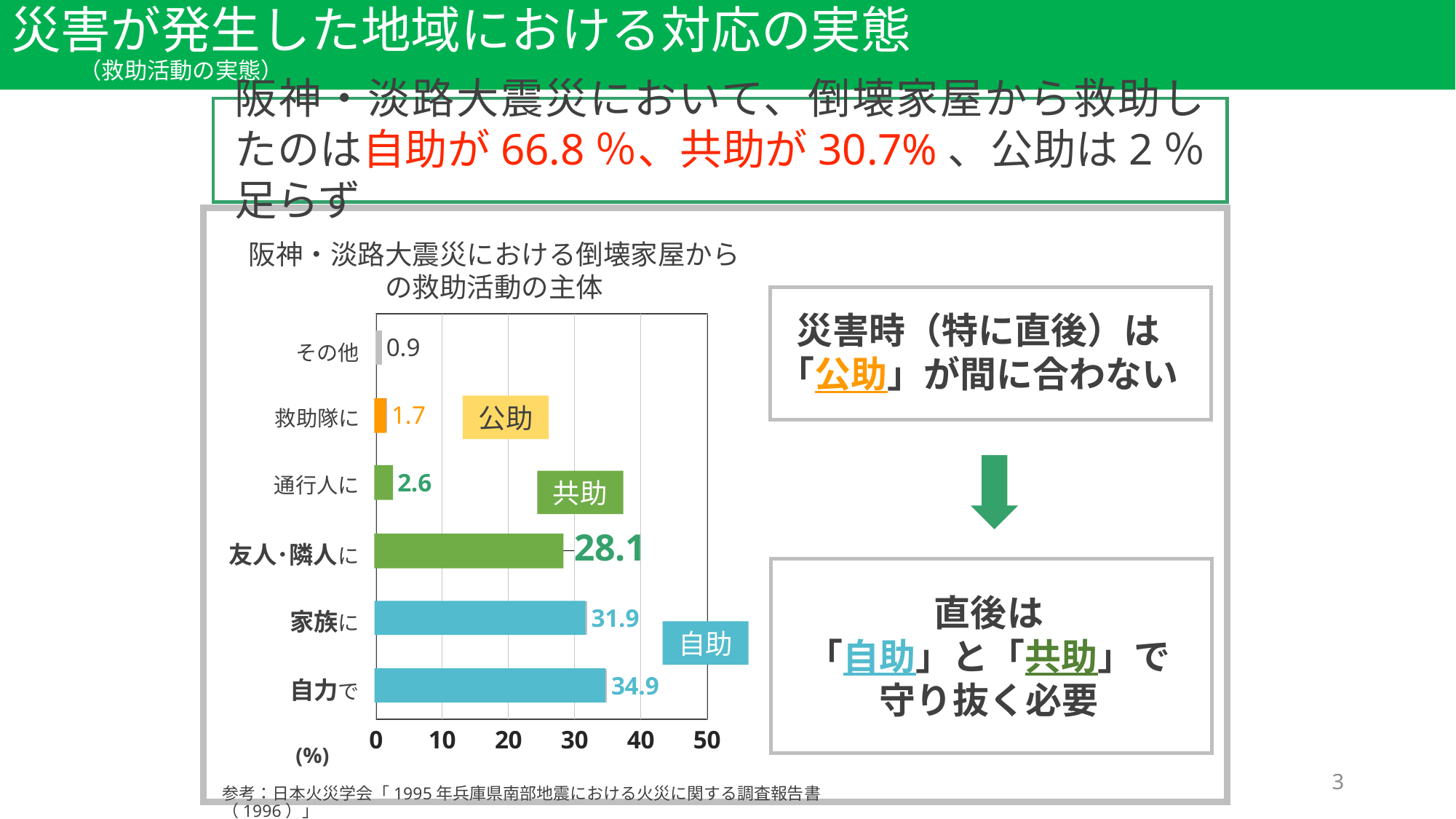
What is the value for 友人・隣人に? 28.1 Which category has the lowest value? その他 What is the difference between the values for 通行人に and 救助隊に? 0.9 How many categories are shown in the chart? 6 What is the value for 救助隊に? 1.7 What is the value for 自力で? 34.9 What is the difference between the values for 自力で and 家族に? 3.0 Which is larger, the value for 家族に or the value for 友人・隣人に? 家族に Which category has the highest value? 自力で What is the title of the chart? 阪神・淡路大震災における倒壊家屋からの救助活動の主体 What kind of chart is shown on the slide? bar chart What is the value for 家族に? 31.9